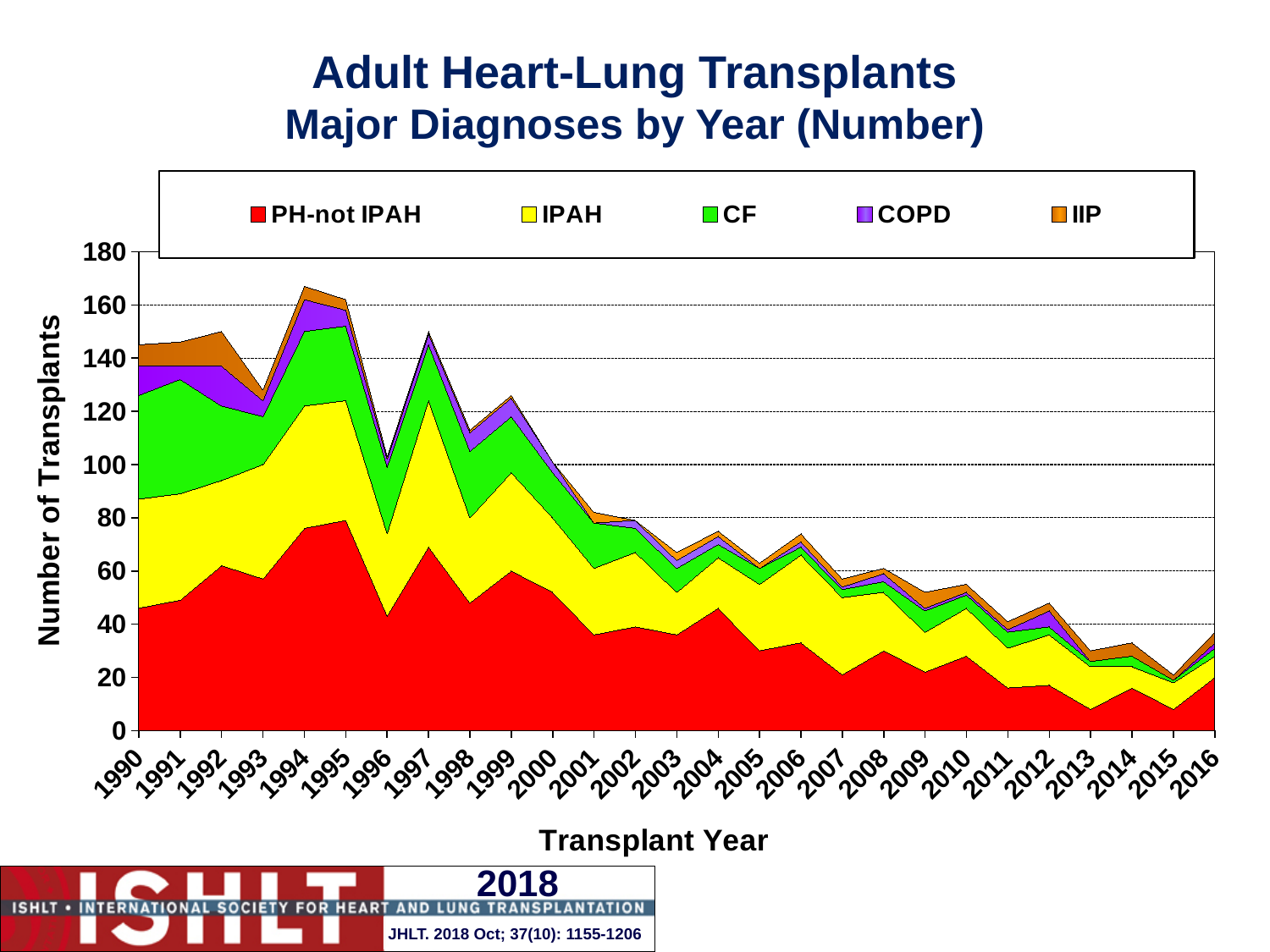
How many series does the legend list? 5 What is the label of the y axis? Number of Transplants What kind of chart is shown on the slide? Stacked area chart Is the total number of transplants in 1994 greater or less than 160? greater Which year has the larger total number of transplants, 1990 or 2016? 1990 Is the total number of transplants in 2016 greater or less than 40? less How many transplant years are plotted along the x axis? 27 Is the number of PH-not IPAH transplants in 1995 greater or less than 60? greater Which year has the lowest total number of transplants? 2015 Overall, do the total numbers of transplants rise or fall from 1990 to 2016? Fall Which colour represents the CF series in the chart? Green